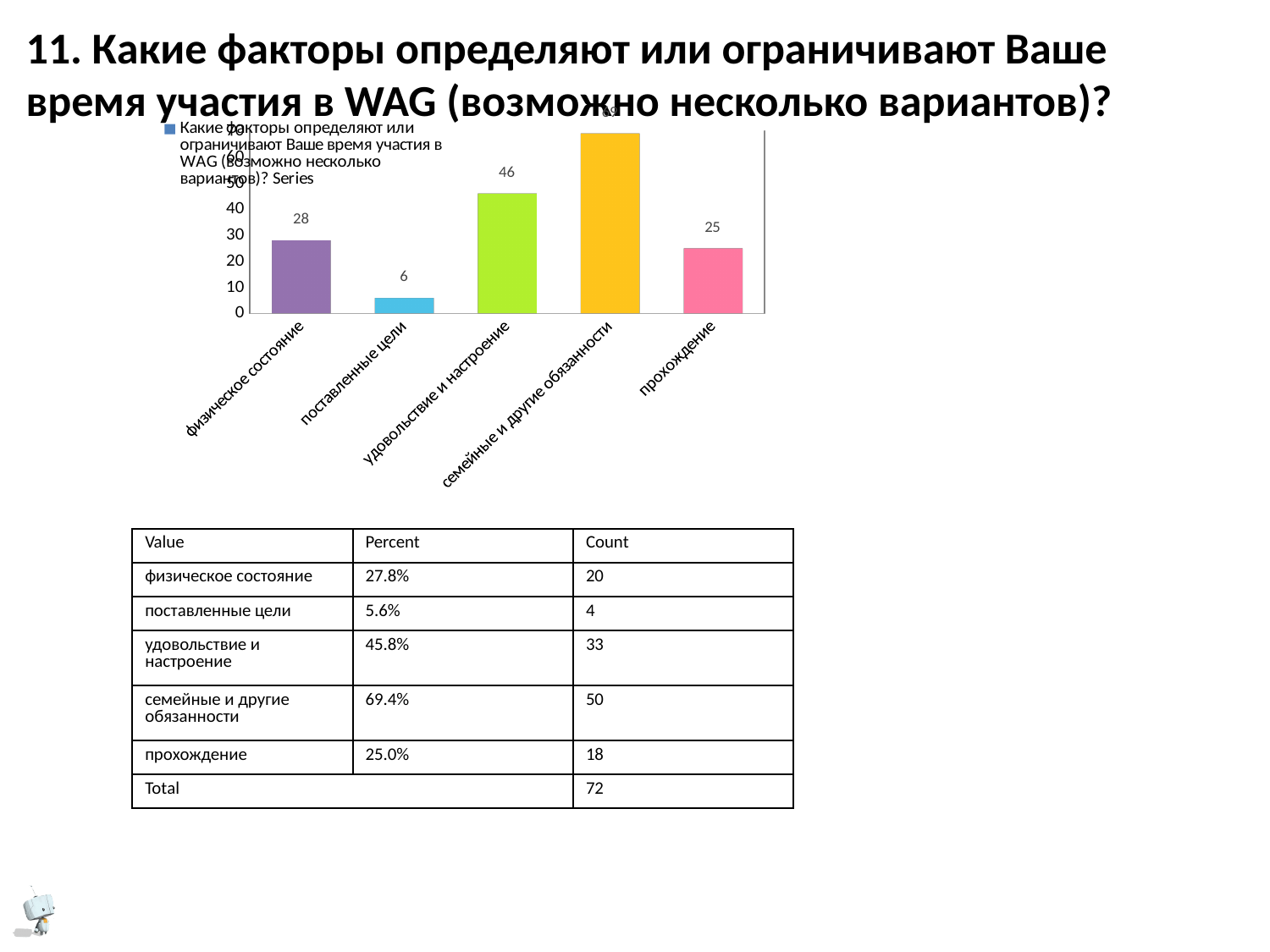
What kind of chart is shown on the slide? bar chart How many categories are shown on the x axis of the chart? 5 Which is larger, the value for прохождение or the value for физическое состояние? физическое состояние What is the value shown for поставленные цели? 6 What is the difference between the values for удовольствие и настроение and физическое состояние? 18 Is the value for семейные и другие обязанности greater or less than 60? greater How many series does the chart legend list? 1 What is the value shown for физическое состояние? 28 What is the value shown for прохождение? 25 Which category has the lowest bar? поставленные цели Which category has the highest bar? семейные и другие обязанности What is the value shown for удовольствие и настроение? 46